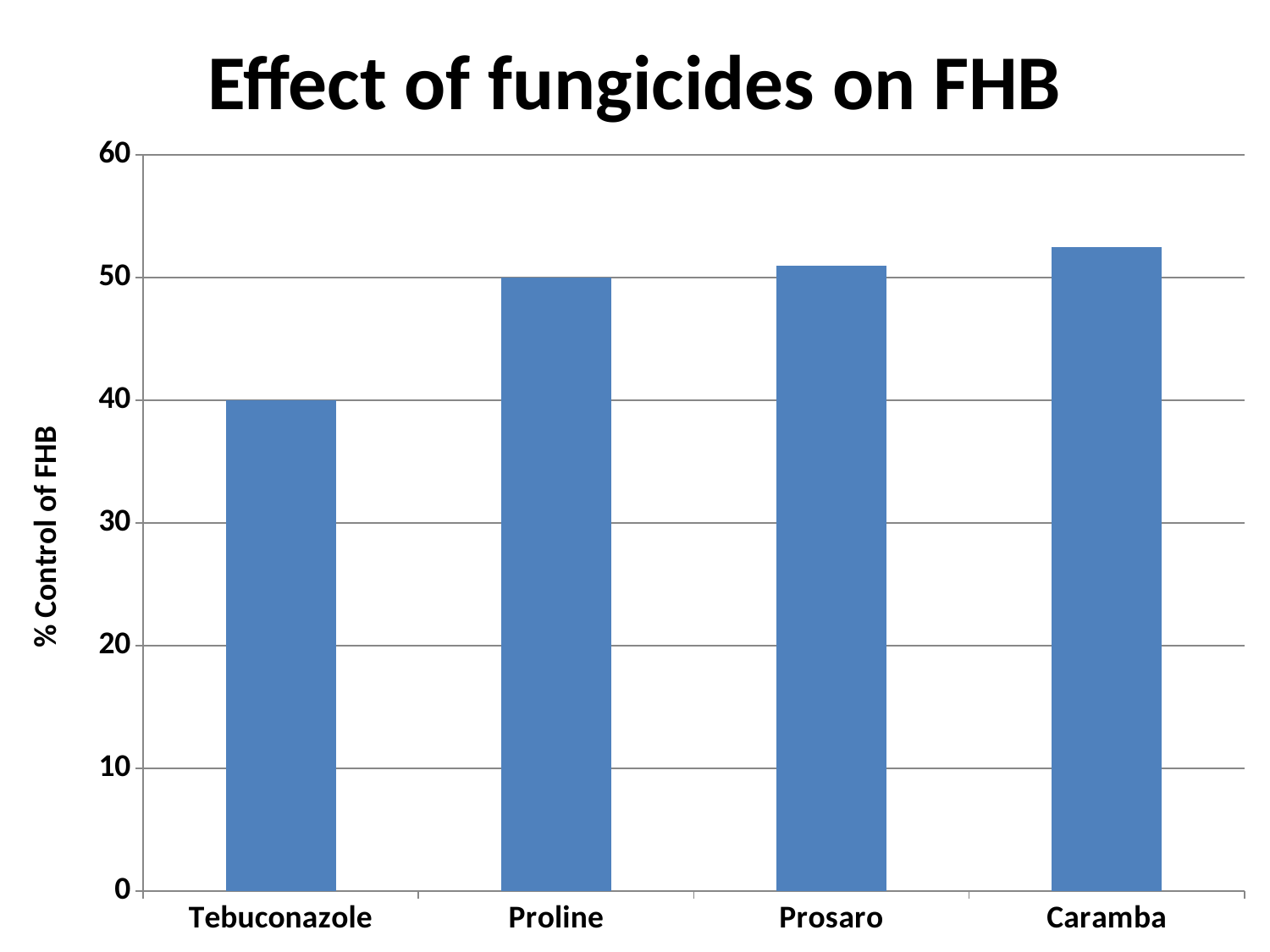
What is the % Control of FHB for Tebuconazole? 40 Is the value for Prosaro greater or less than 50? greater How many fungicides are shown in the chart? 4 What is the % Control of FHB for Proline? 50 What is the label of the vertical axis? % Control of FHB What type of chart is shown on the slide? Bar chart Which fungicide has the lowest % Control of FHB? Tebuconazole Which has a higher % Control of FHB, Tebuconazole or Prosaro? Prosaro What is the difference in % Control of FHB between Proline and Tebuconazole? 10 Which fungicide has the highest % Control of FHB? Caramba What is the title of the chart? Effect of fungicides on FHB Do the values rise or fall from left to right across the fungicides? Rise